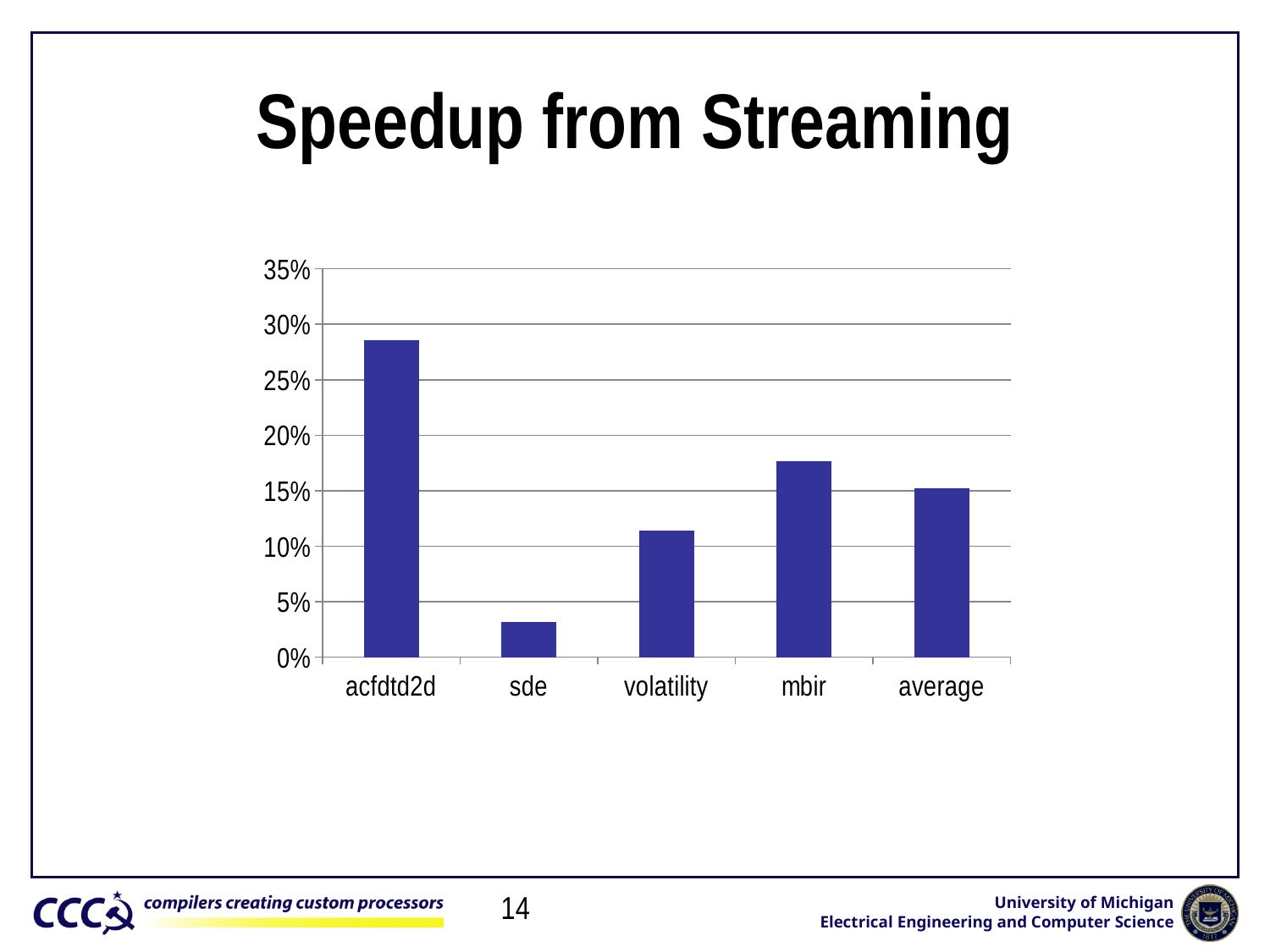
Is the value for acfdtd2d greater or less than 25%? greater Which category has the lowest speedup? sde What is the title of the chart? Speedup from Streaming Which is larger, the value for average or the value for sde? average Is the value for mbir greater or less than 20%? less Which category has the highest speedup? acfdtd2d Which is larger, the value for mbir or the value for volatility? mbir Is the value for volatility greater or less than 10%? greater How many categories are shown on the x axis of the chart? 5 What kind of chart is shown on the slide? bar chart